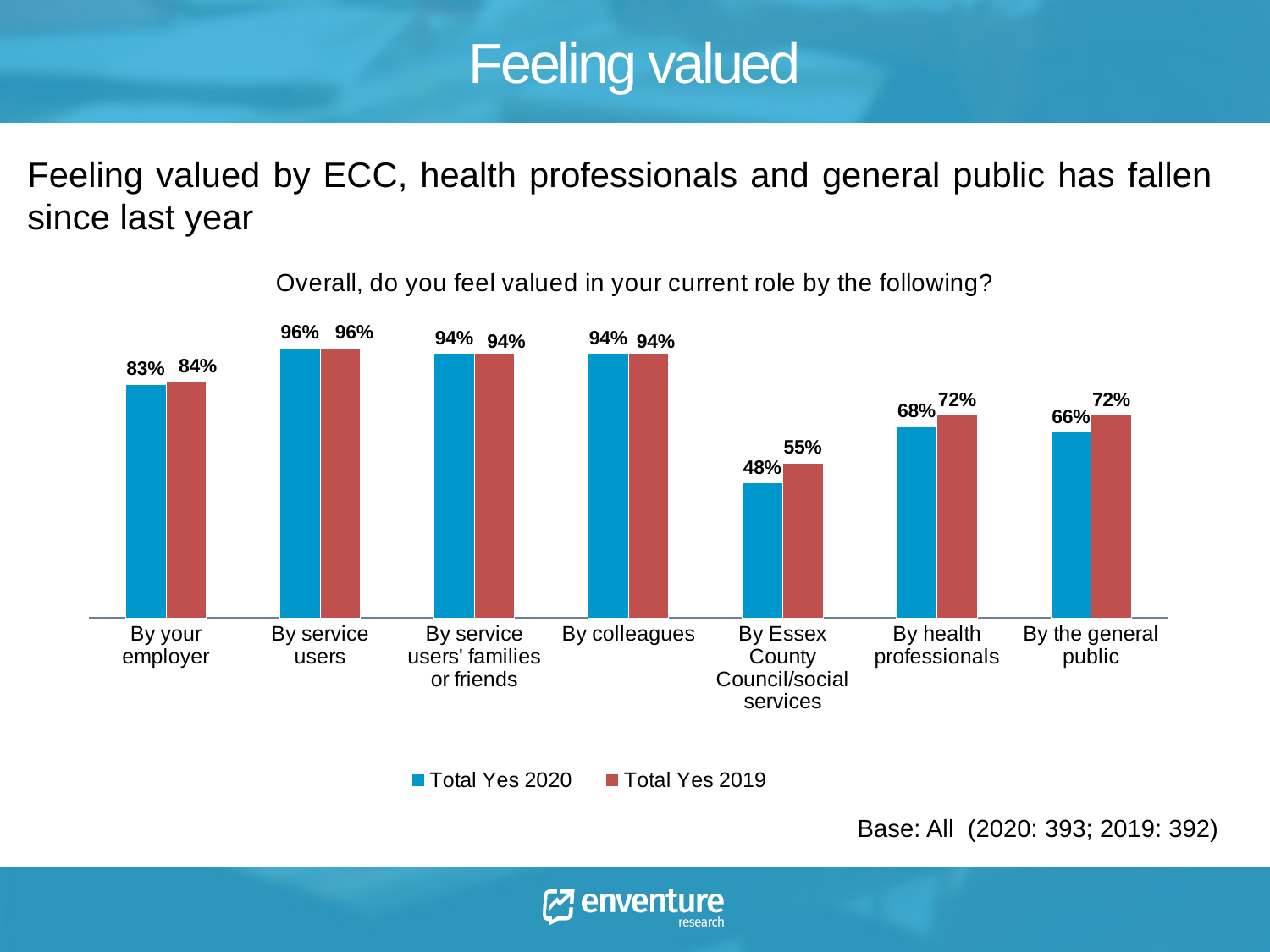
What is the difference between the Total Yes 2019 and Total Yes 2020 values for 'By the general public'? 6% What is the Total Yes 2020 value for 'By your employer'? 83% What is the Total Yes 2019 value for 'By the general public'? 72% What is the difference between the Total Yes 2019 and Total Yes 2020 values for 'By Essex County Council/social services'? 7% Which category has the highest Total Yes 2020 value? By service users What is the question shown as the chart's title? Overall, do you feel valued in your current role by the following? How many categories are shown on the x axis of the chart? 7 How many series does the legend list? 2 What is the Total Yes 2020 value for 'By Essex County Council/social services'? 48% What kind of chart is shown on the slide? Bar chart Which is larger for 'By health professionals': the Total Yes 2020 value or the Total Yes 2019 value? Total Yes 2019 Which category has the lowest Total Yes 2019 value? By Essex County Council/social services